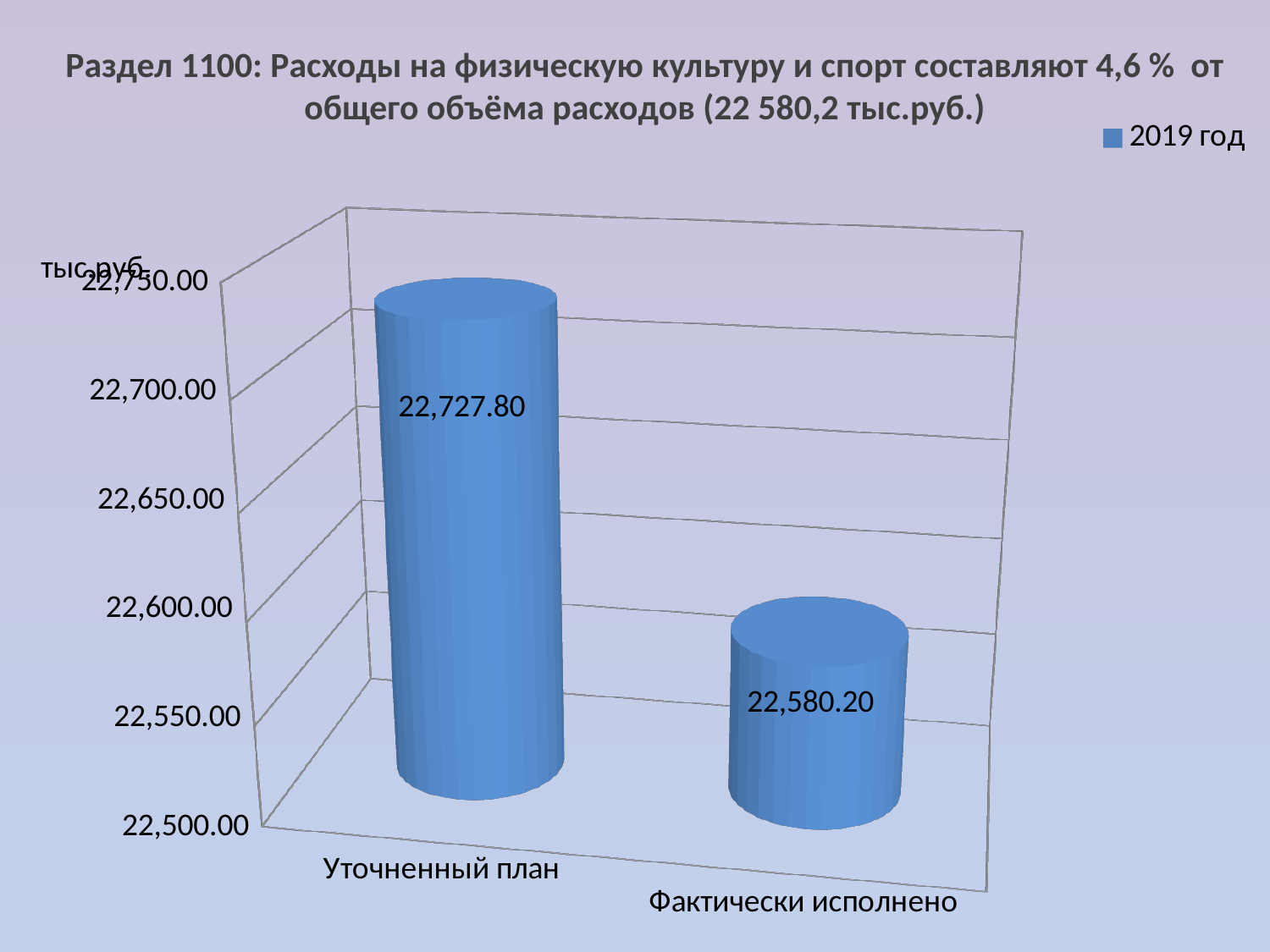
Which category has the lowest value? Фактически исполнено How many series does the legend list? 1 Is the value for Уточненный план greater or less than 22,700.00? greater What is the value for Фактически исполнено? 22,580.20 Which is larger, Уточненный план or Фактически исполнено? Уточненный план What series name is shown in the legend? 2019 год How many categories are shown on the chart? 2 What kind of chart is shown? bar chart Is the value for Фактически исполнено greater or less than 22,600.00? less Which category has the highest value? Уточненный план What is the difference between Уточненный план and Фактически исполнено? 147.60 What is the value for Уточненный план? 22,727.80